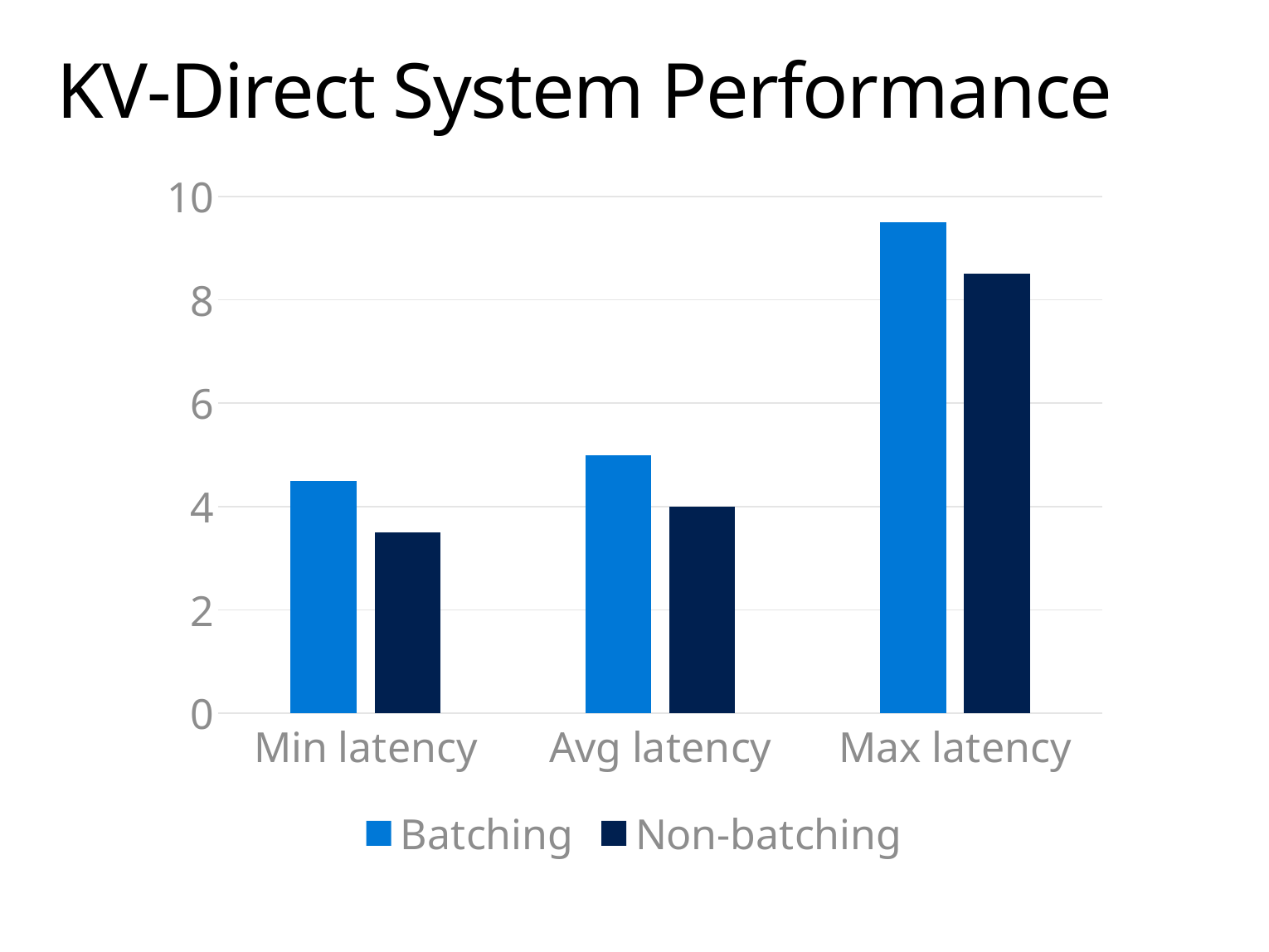
Is the Non-batching value for Min latency greater or less than 4? less How many series does the legend list? 2 Which category has the lowest Non-batching value? Min latency What kind of chart is shown on the slide? bar chart For Max latency, which series has the larger value, Batching or Non-batching? Batching Is the Batching value for Min latency greater or less than 4? greater Do the Batching values rise or fall from Min latency to Max latency? rise Which series is shown in the darker navy colour? Non-batching How many categories are shown on the x axis? 3 Is the Batching value for Max latency greater or less than 8? greater Which category has the highest Batching value? Max latency What is the title of the chart? KV-Direct System Performance